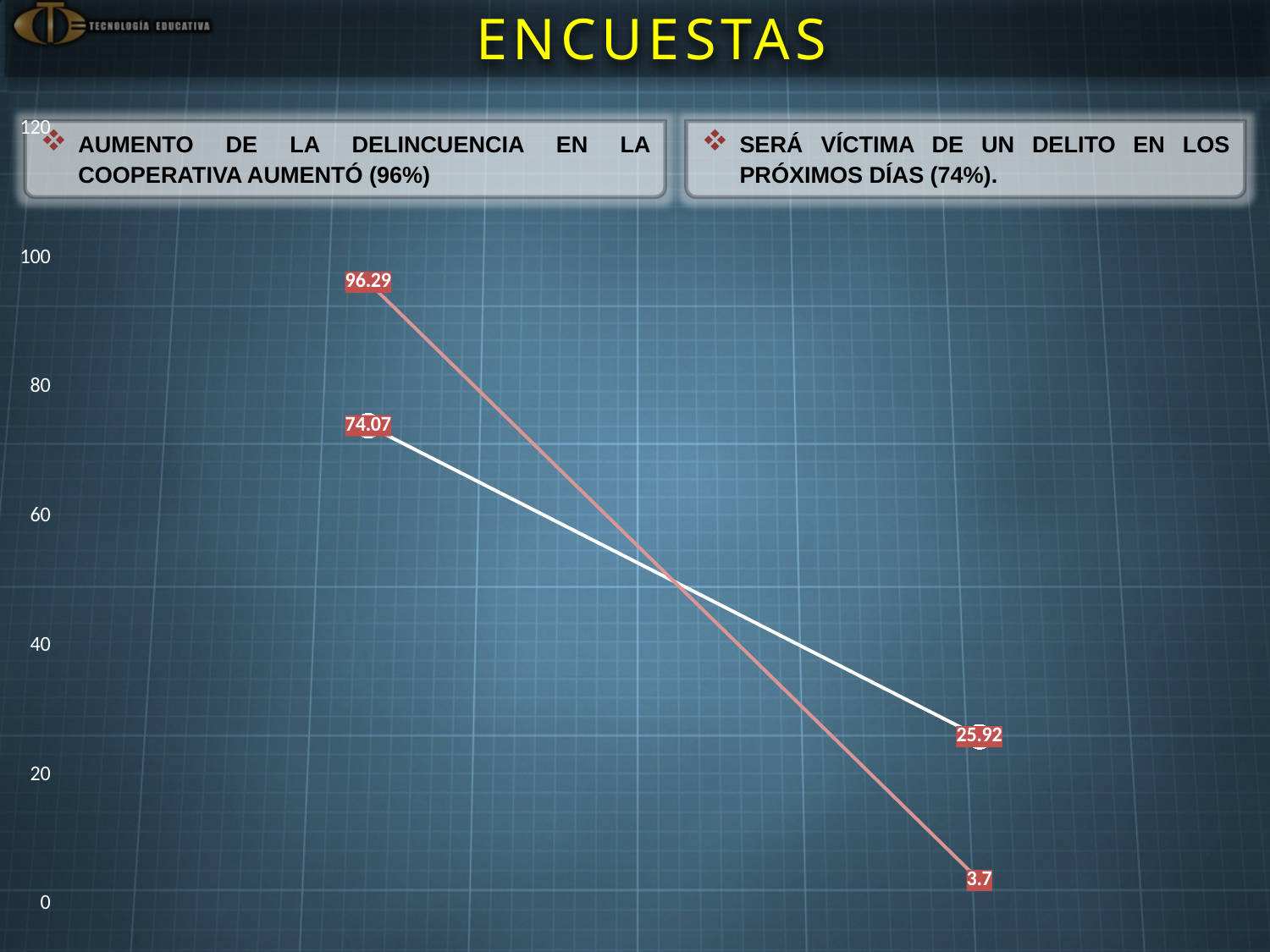
At the right end of the chart, which line has the higher value, the pink line or the white line? the white line What is the difference between the first and last values on the pink line (96.29 and 3.7)? 92.59 What is the value of the last (right) point on the pink line? 3.7 What is the value of the first (left) point on the white line? 74.07 What is the value of the last (right) point on the white line? 25.92 What is the highest tick value shown on the vertical axis? 120 What is the difference between the first and last values on the white line (74.07 and 25.92)? 48.15 Do the values on the pink line rise or fall from left to right? fall At the left end of the chart, which line has the higher value, the pink line or the white line? the pink line How many lines are plotted on the chart? 2 What kind of chart is shown on the slide? line chart What is the value of the first (left) point on the pink line? 96.29